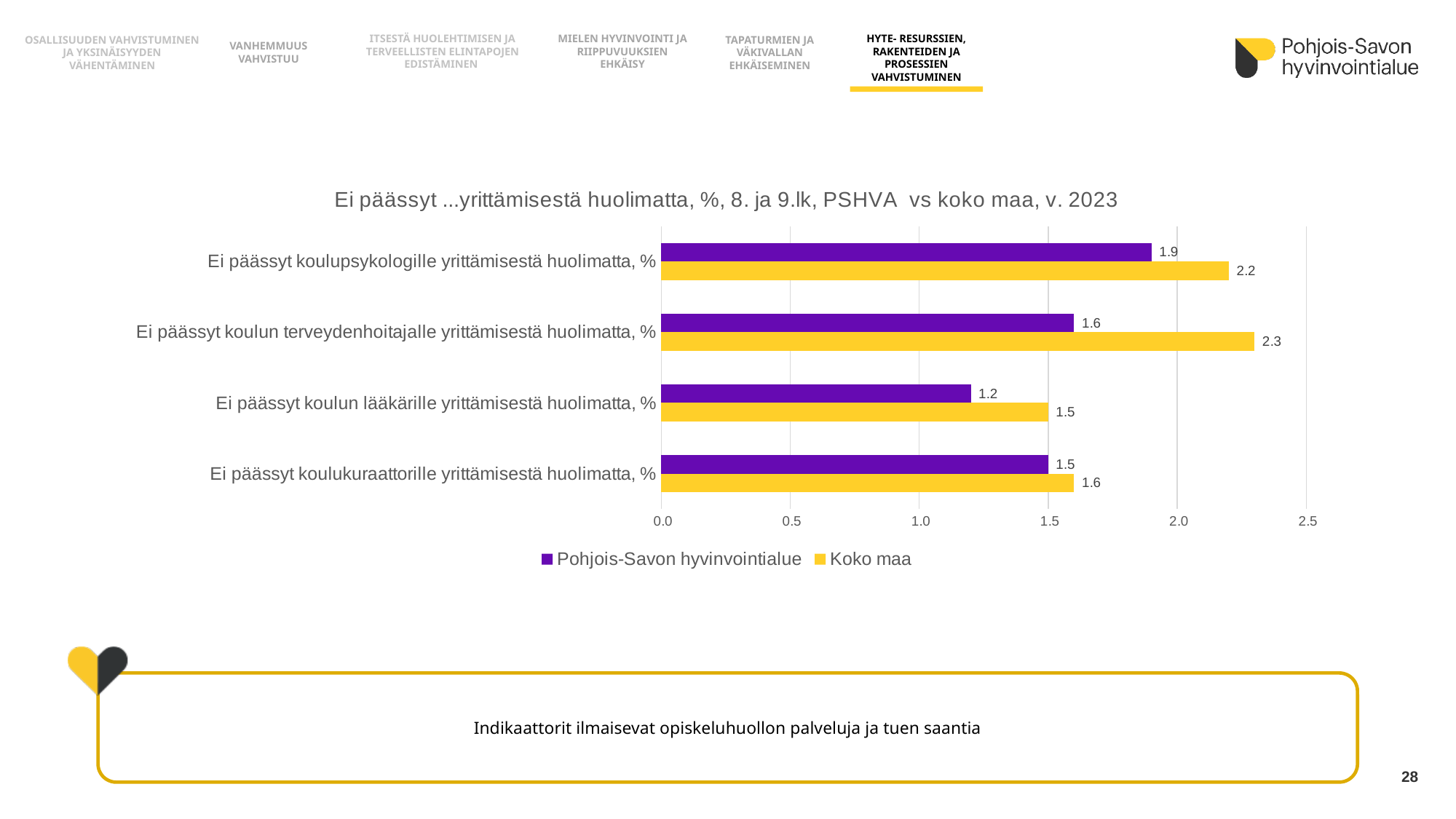
What is the value for Pohjois-Savon hyvinvointialue for 'Ei päässyt koulun lääkärille yrittämisestä huolimatta, %'? 1.2 What kind of chart is shown on the slide? bar chart What is the difference between Koko maa and Pohjois-Savon hyvinvointialue for 'Ei päässyt koulun terveydenhoitajalle yrittämisestä huolimatta, %'? 0.7 What is the value for Koko maa for 'Ei päässyt koulun terveydenhoitajalle yrittämisestä huolimatta, %'? 2.3 What is the value for Koko maa for 'Ei päässyt koulukuraattorille yrittämisestä huolimatta, %'? 1.6 How many categories are plotted in the chart? 4 For 'Ei päässyt koulupsykologille yrittämisestä huolimatta, %', which series has the larger value, Pohjois-Savon hyvinvointialue or Koko maa? Koko maa What is the value for Pohjois-Savon hyvinvointialue for 'Ei päässyt koulupsykologille yrittämisestä huolimatta, %'? 1.9 Which series is shown in purple in the legend? Pohjois-Savon hyvinvointialue How many series does the legend list? 2 Which category has the lowest value for Pohjois-Savon hyvinvointialue? Ei päässyt koulun lääkärille yrittämisestä huolimatta, % Which category has the highest value for Koko maa? Ei päässyt koulun terveydenhoitajalle yrittämisestä huolimatta, %